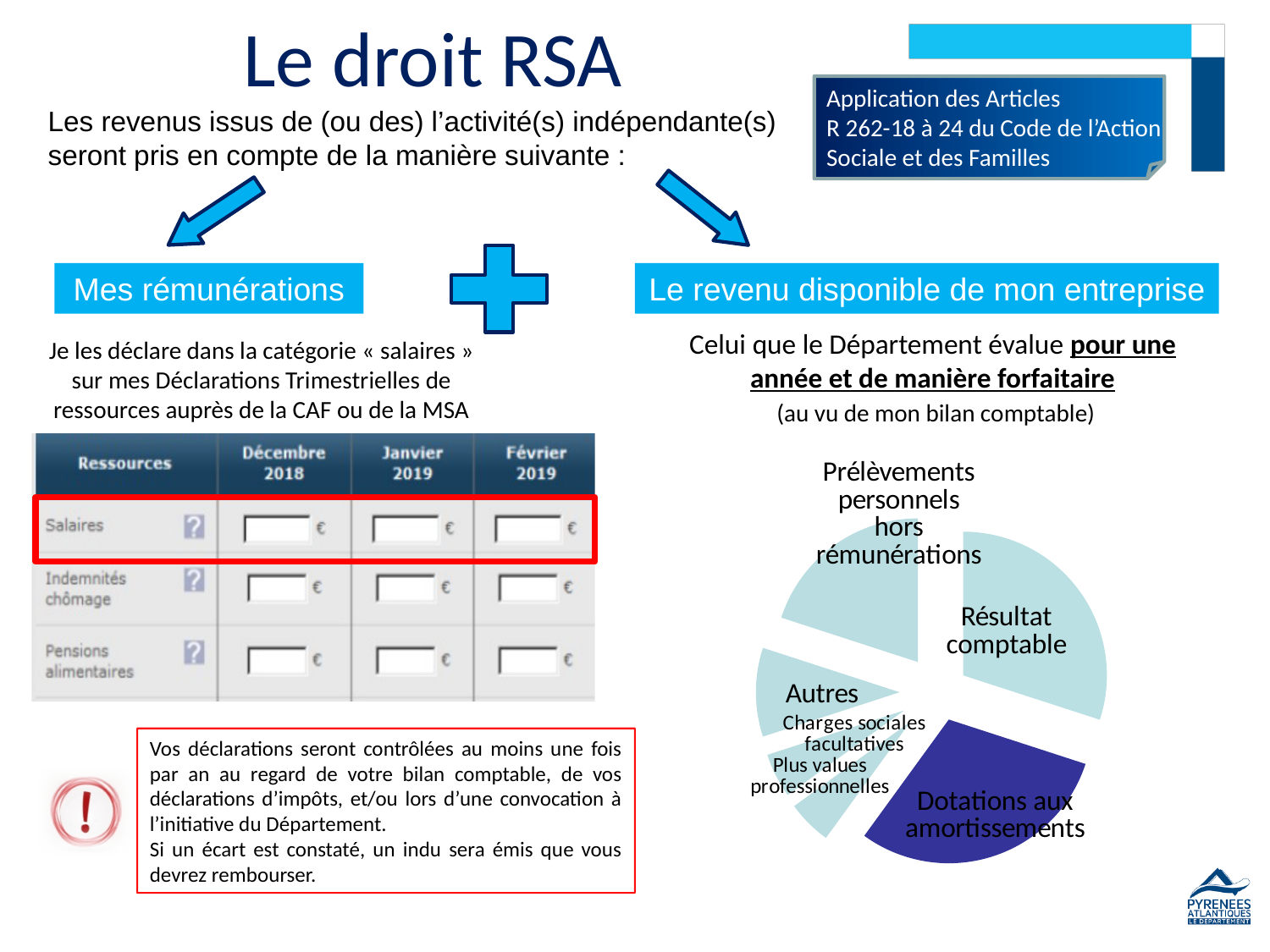
How many slices does the pie chart on the slide have? 6 Does the pie chart on the slide display any numeric data labels on its slices? No Which slice of the pie chart is coloured dark blue, unlike the other slices? Dotations aux amortissements In the pie chart, which slice is larger: "Résultat comptable" or "Plus values professionnelles"? Résultat comptable In the pie chart, which slice is larger: "Résultat comptable" or "Charges sociales facultatives"? Résultat comptable What kind of chart is shown on the right side of the slide under "Le revenu disponible de mon entreprise"? pie chart In the pie chart, which slice is larger: "Dotations aux amortissements" or "Charges sociales facultatives"? Dotations aux amortissements